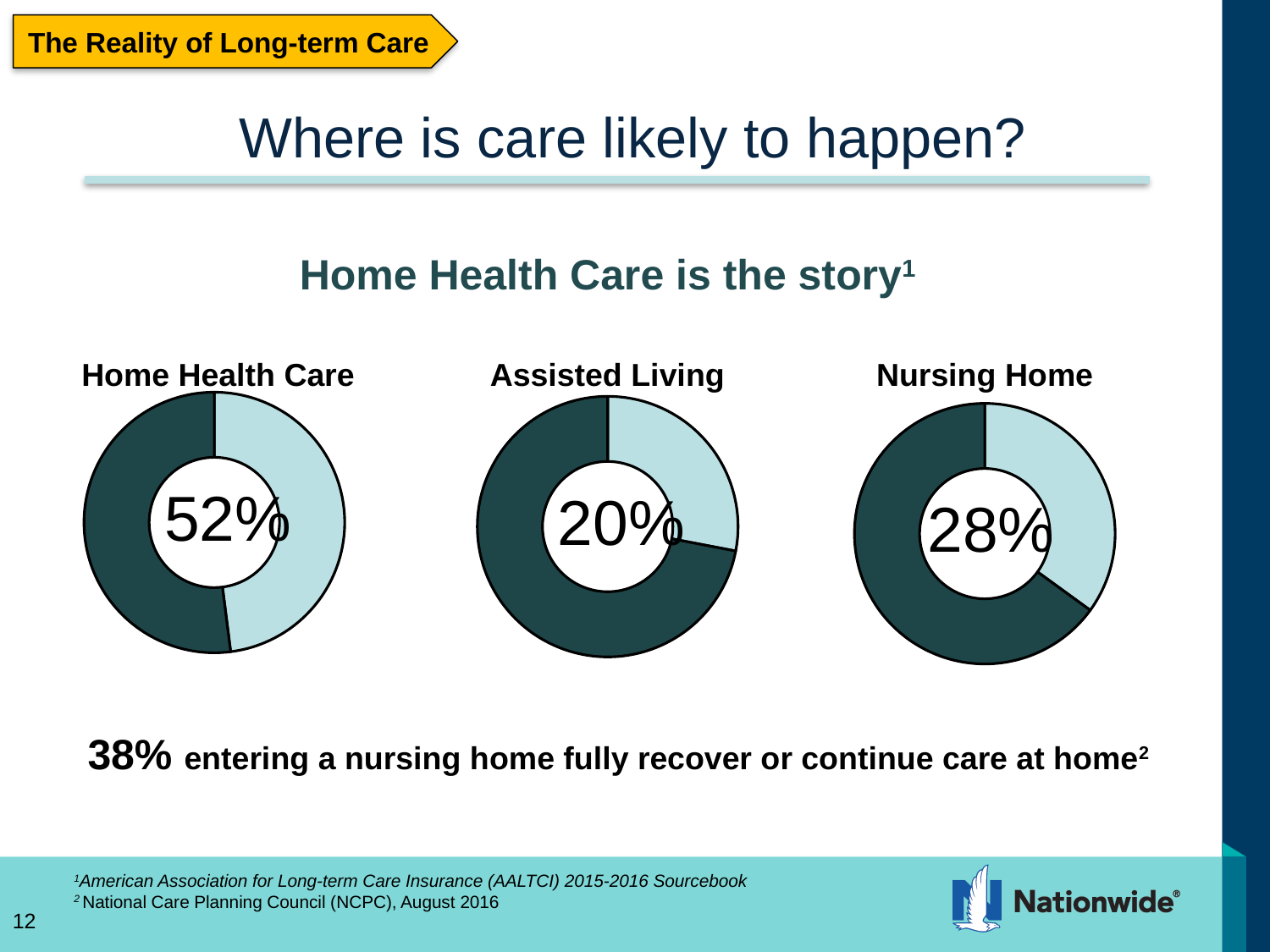
What percentage is shown in the Assisted Living donut chart? 20% In the Home Health Care chart, what colour is the slice representing the 52%? Dark teal Which of the three care settings shows the highest percentage? Home Health Care How many donut charts are shown on the slide? 3 What is the difference in percentage points between the Nursing Home chart and the Assisted Living chart? 8 percentage points What percentage is shown in the Nursing Home donut chart? 28% What percentage is shown in the Home Health Care donut chart? 52% Which shows a larger percentage, the Nursing Home chart or the Assisted Living chart? Nursing Home What is the heading printed above the three charts? Home Health Care is the story What is the difference in percentage points between the Home Health Care chart and the Nursing Home chart? 24 percentage points What kind of chart is used to show the percentage for each care setting? Donut (pie) chart Which of the three care settings shows the lowest percentage? Assisted Living